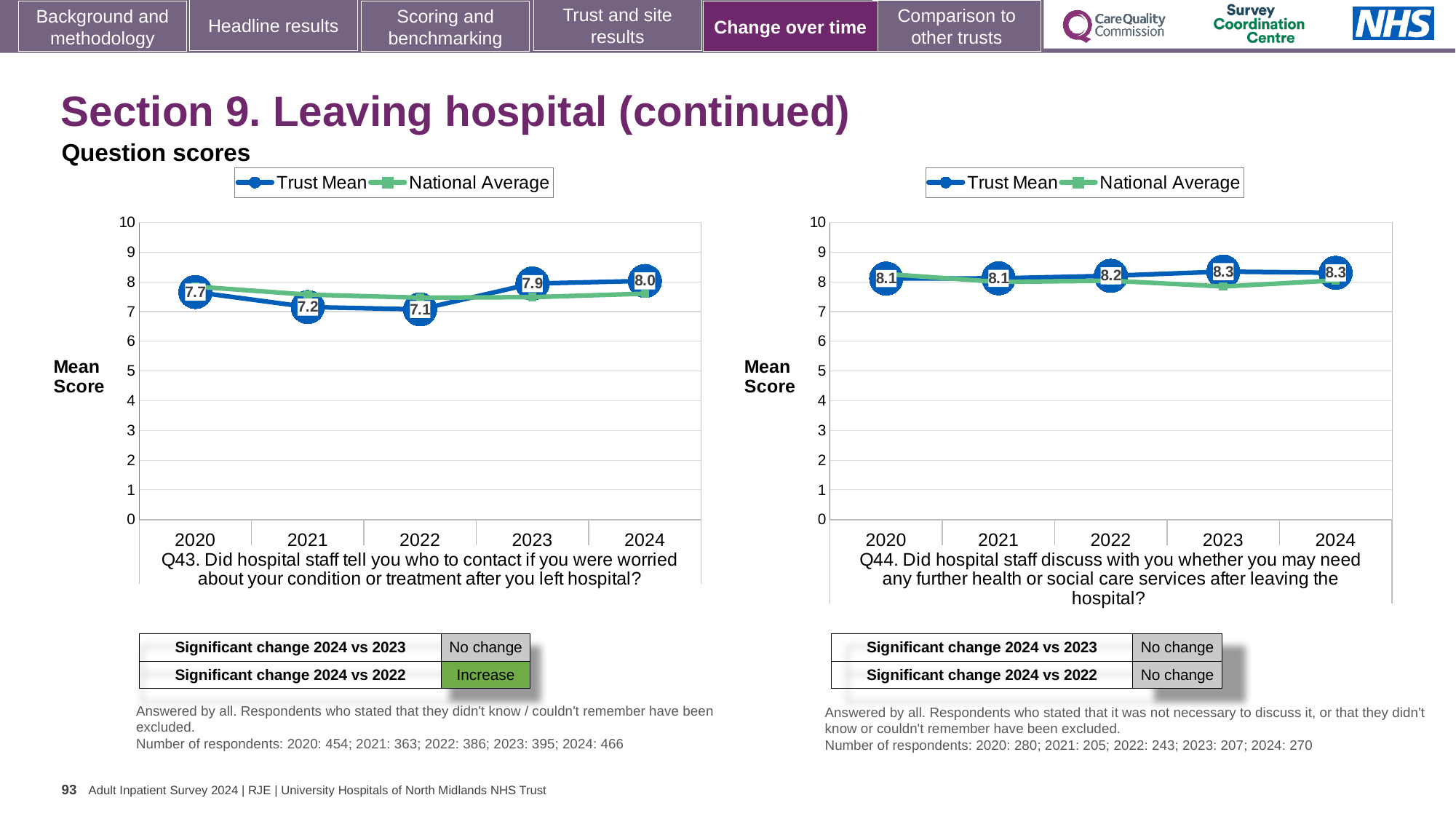
In the Q43 chart on the left, which year has the lowest Trust Mean score? 2022 What kind of chart is the Q44 chart on the right? line chart In the Q43 chart on the left, what is the Trust Mean score for 2021? 7.2 How many years are plotted on the x axis of the Q44 chart on the right? 5 In the Q43 chart on the left, what is the Trust Mean score for 2024? 8.0 In the Q43 chart on the left, what is the difference between the Trust Mean scores for 2024 and 2022? 0.9 In the Q43 chart on the left, is the National Average value for 2021 greater or less than 7? greater In the Q44 chart on the right, what is the Trust Mean score for 2022? 8.2 In the Q43 chart on the left, is the Trust Mean score for 2020 larger or smaller than the Trust Mean score for 2021? larger In the Q43 chart on the left, which year has the highest Trust Mean score? 2024 In the Q44 chart on the right, what is the difference between the Trust Mean scores for 2023 and 2020? 0.2 How many series does the legend of the Q43 chart on the left list? 2